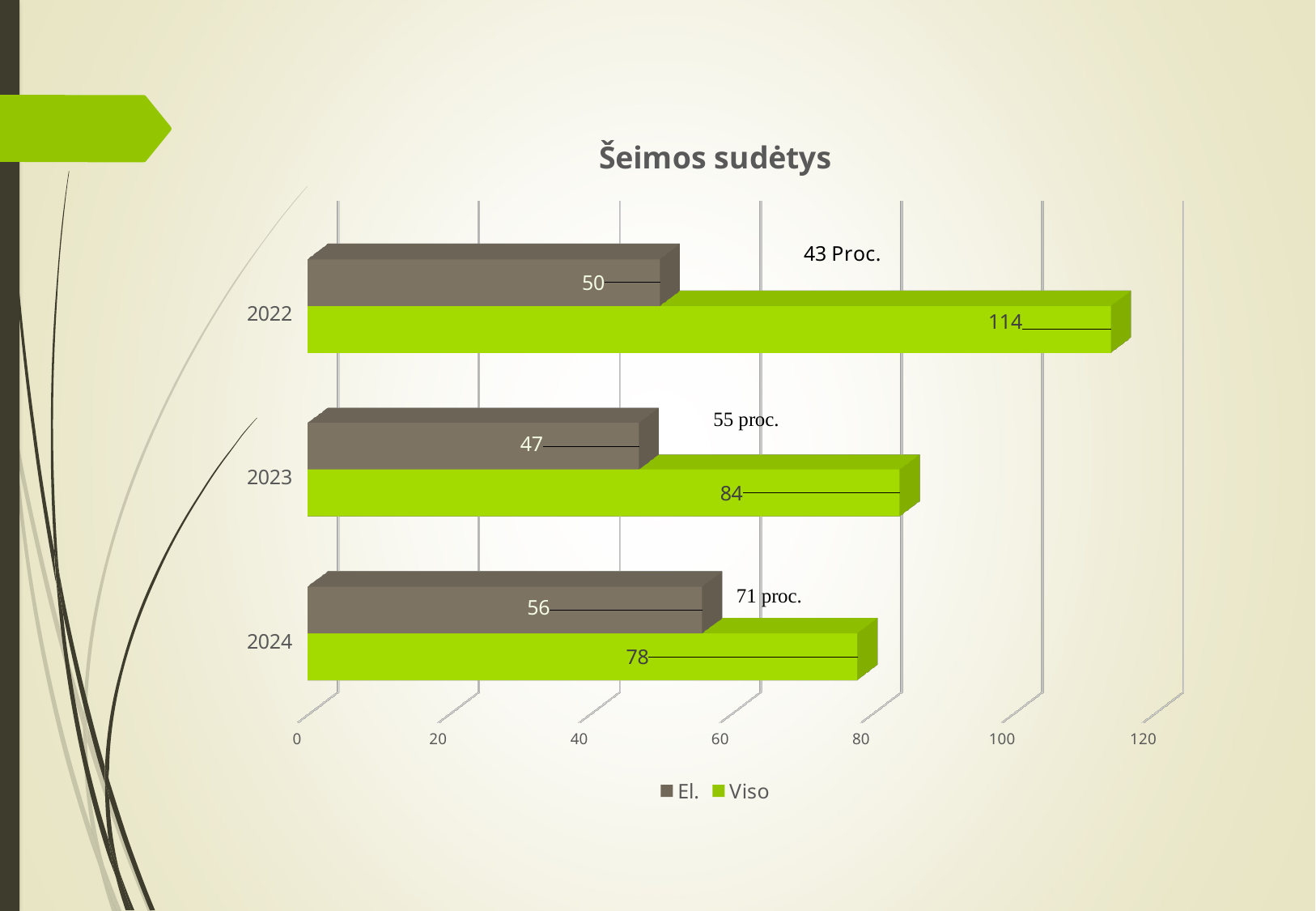
What is the title of the chart? Šeimos sudėtys What is the value of El. for 2023? 47 Which year has the highest Viso value? 2022 What is the value of El. for 2024? 56 Which year has the lowest El. value? 2023 How many series does the legend list? 2 What is the value of Viso for 2022? 114 What is the value of Viso for 2024? 78 Which is larger, the Viso value for 2023 or the Viso value for 2024? Viso for 2023 What is the difference between Viso and El. for 2023? 37 What kind of chart is this? Bar chart How many years are shown on the chart? 3